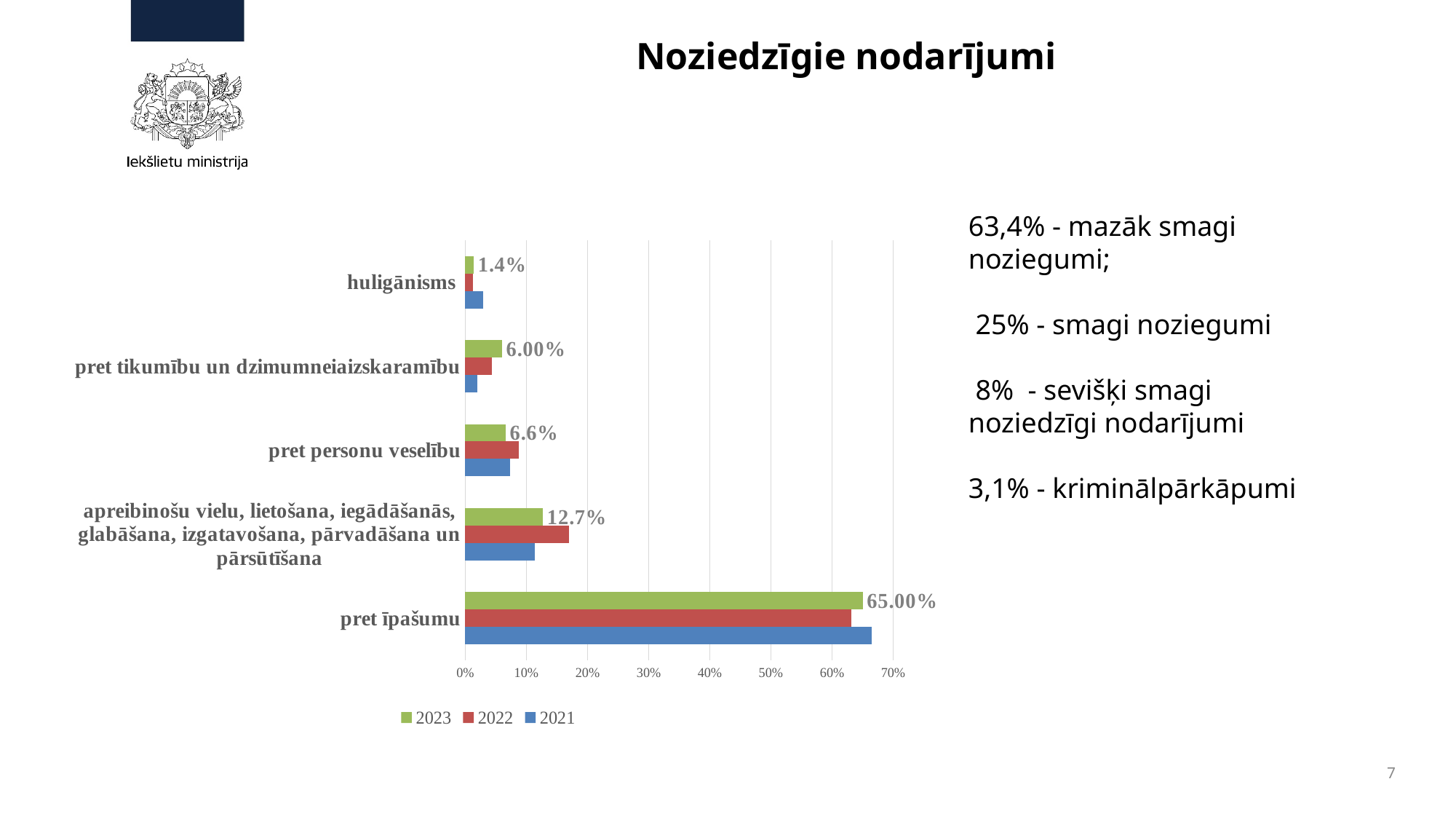
What kind of chart is shown on the slide? bar chart Is the 2021 value for pret īpašumu greater or less than 60%? greater What is the 2023 value for pret īpašumu? 65.00% What is the 2023 value for huligānisms? 1.4% Which category has the highest 2023 value? pret īpašumu What is the 2023 value for pret personu veselību? 6.6% How many series does the legend list? 3 What is the difference between the 2023 values for pret īpašumu and apreibinošu vielu, lietošana, iegādāšanās, glabāšana, izgatavošana, pārvadāšana un pārsūtīšana? 52.3% What is the 2023 value for apreibinošu vielu, lietošana, iegādāšanās, glabāšana, izgatavošana, pārvadāšana un pārsūtīšana? 12.7% How many categories are shown on the chart? 5 For pret īpašumu, which is larger: the 2021 value or the 2022 value? 2021 Which category has the lowest 2023 value? huligānisms